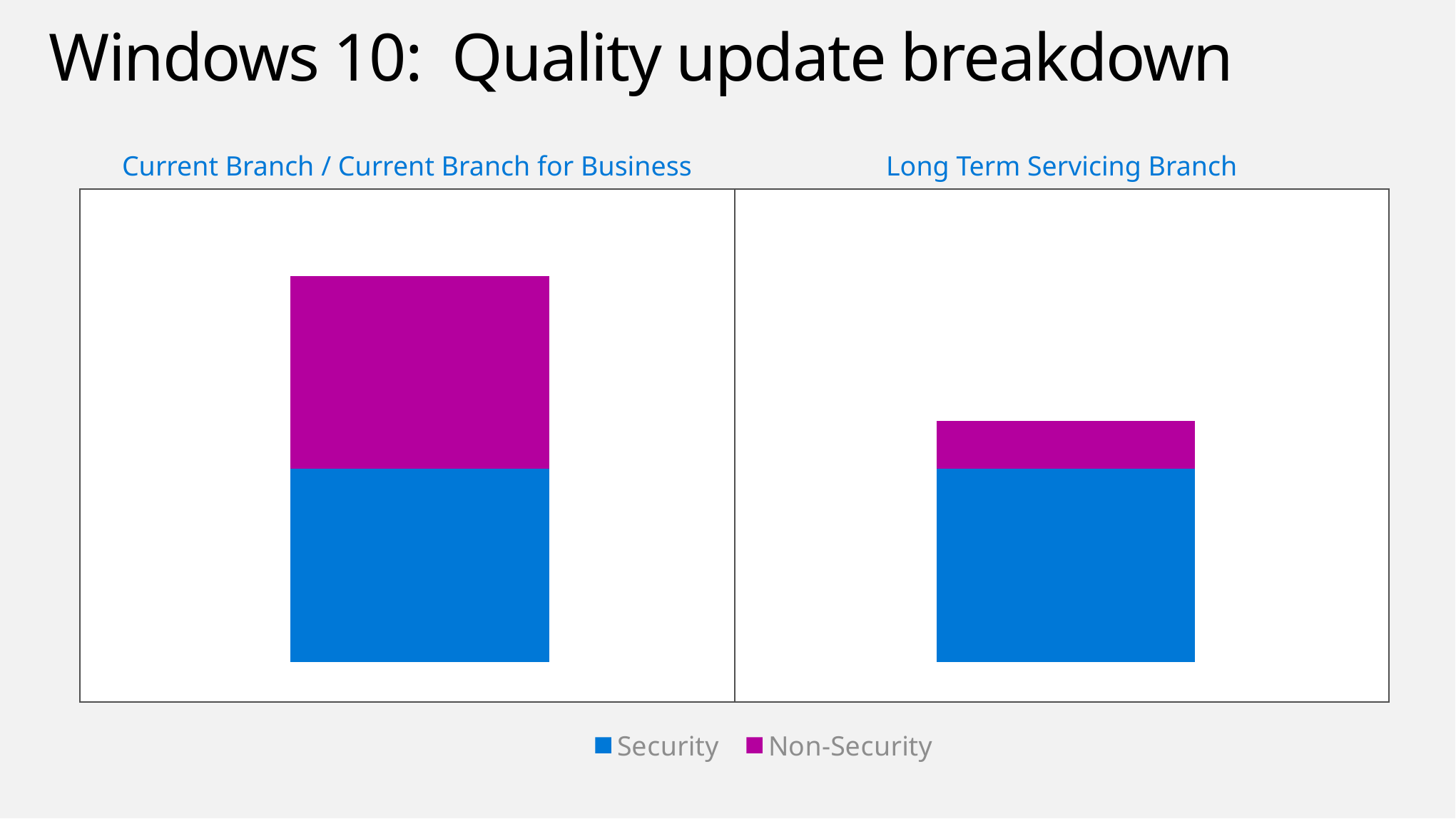
How many categories (bars) does the chart show? 2 What are the two series named in the legend? Security and Non-Security Is the Security segment for Long Term Servicing Branch taller, shorter, or about the same height as the Security segment for Current Branch / Current Branch for Business? About the same How many series does the legend list? 2 For Long Term Servicing Branch, which series is larger, Security or Non-Security? Security Which category has the larger Non-Security segment, Current Branch / Current Branch for Business or Long Term Servicing Branch? Current Branch / Current Branch for Business What colour represents the Non-Security series? Magenta Which category has the tallest total bar? Current Branch / Current Branch for Business Which category has the shortest total bar? Long Term Servicing Branch What kind of chart is shown on the slide? Stacked bar chart